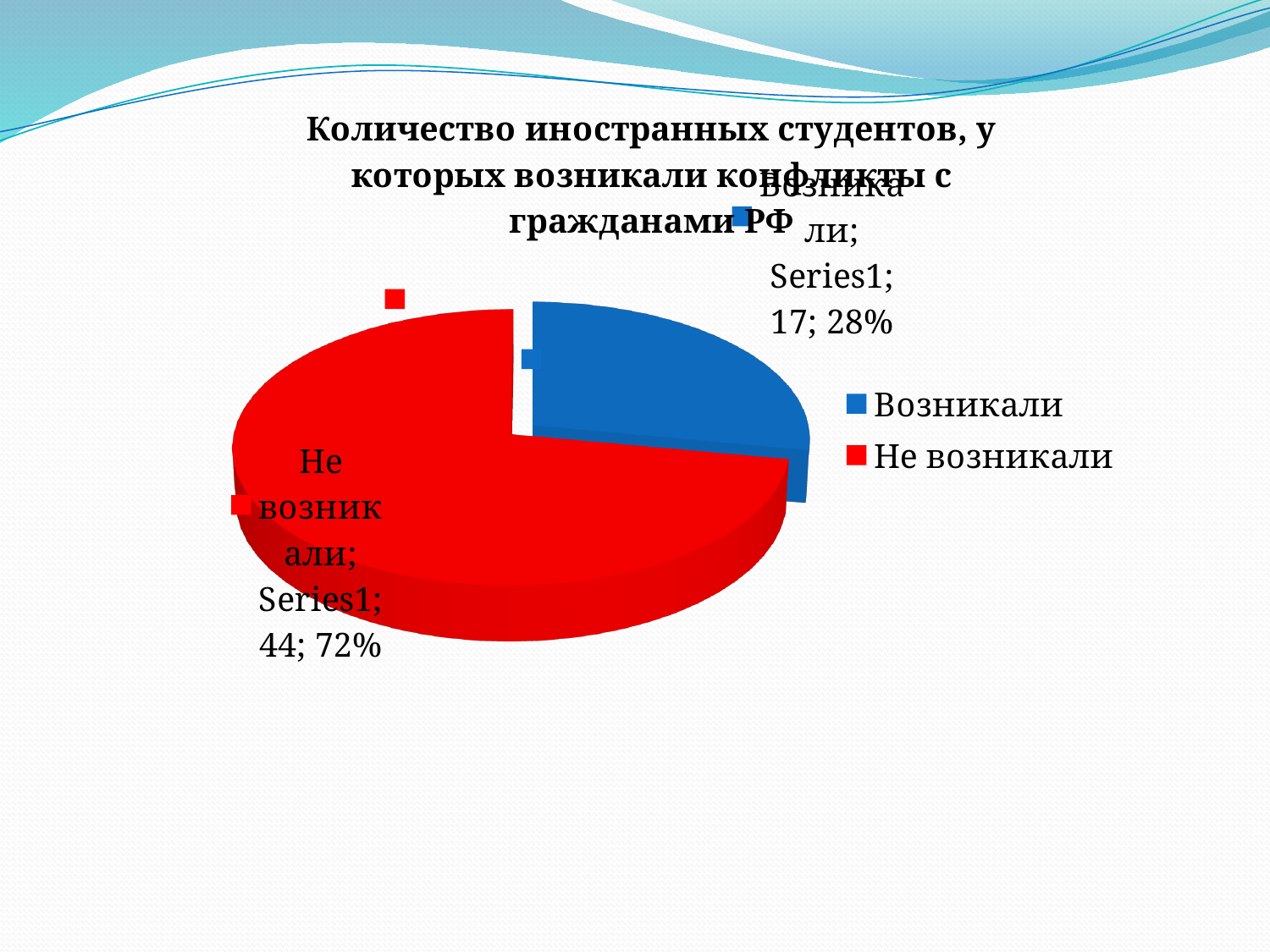
What share of the pie does "Возникали" represent? 28% What is the total of the two values shown in the pie chart? 61 What is the difference between the values for "Не возникали" and "Возникали"? 27 Which is larger, the value for "Возникали" or "Не возникали"? Не возникали What share of the pie does "Не возникали" represent? 72% What is the value for "Не возникали"? 44 How many categories does the pie chart have? 2 What is the value for "Возникали"? 17 Which category has the smallest slice? Возникали What colour is the slice for "Не возникали"? red Which category has the largest slice? Не возникали What kind of chart is shown on the slide? pie chart